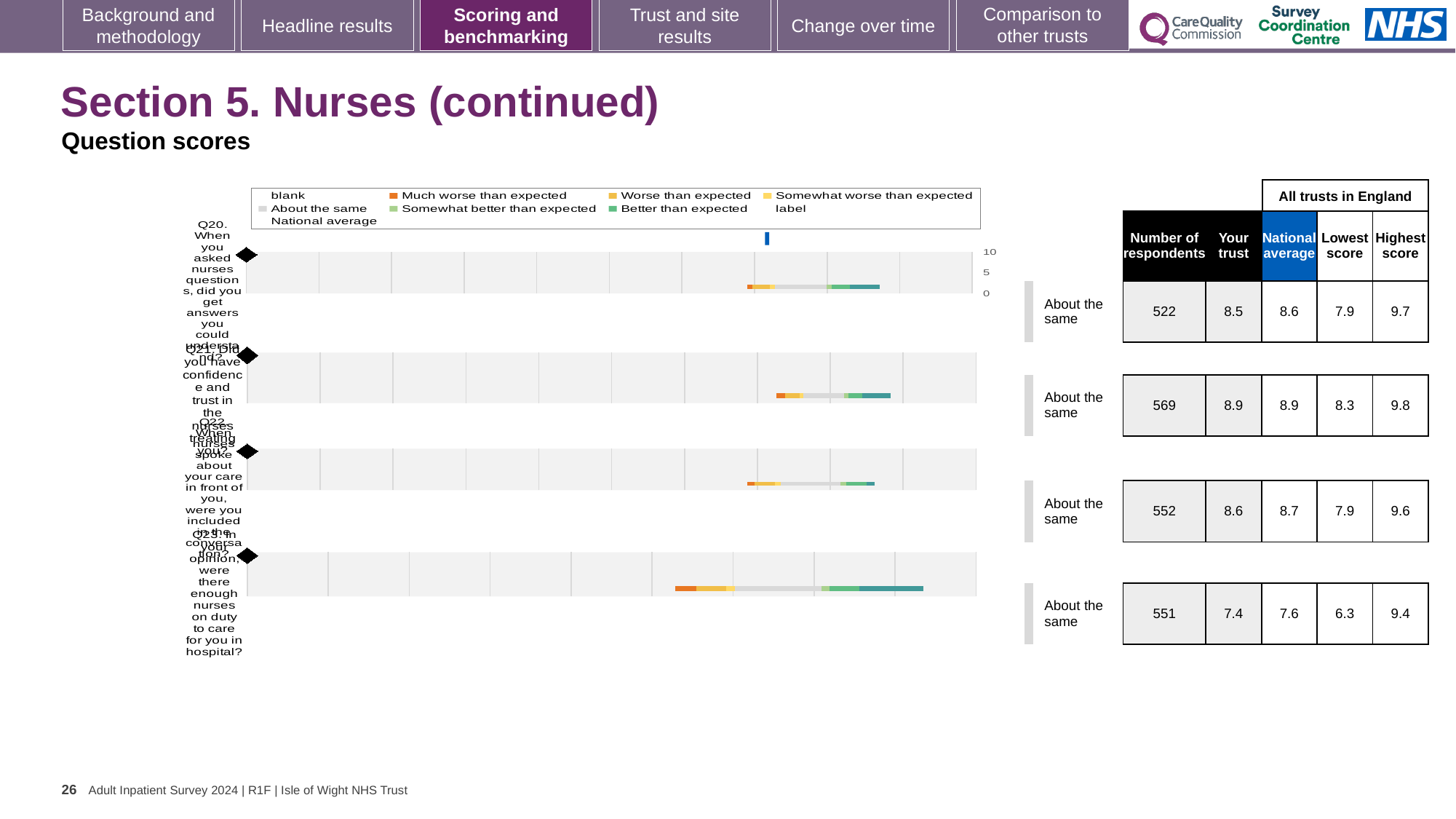
How many respondents answered Q22 (When nurses spoke about your care in front of you, were you included in the conversation)? 552 Which question has the lowest 'Your trust' score? Q23 Which has the higher 'Your trust' score, Q21 or Q23? Q21 What benchmark category is shown next to the chart for Q20 (When you asked nurses questions, did you get answers you could understand)? About the same What is the national average score for Q21 (Did you have confidence and trust in the nurses treating you)? 8.9 Which question has the highest 'Your trust' score? Q21 What kind of chart is used to show the question scores on this slide? bar chart What is the 'Your trust' score for Q23 (were there enough nurses on duty to care for you in hospital)? 7.4 How many questions (Q20 to Q23) are plotted in the question scores chart? 4 What is the difference between the highest score and the lowest score across all trusts in England for Q20? 1.8 What is the lowest score across all trusts in England for Q23? 6.3